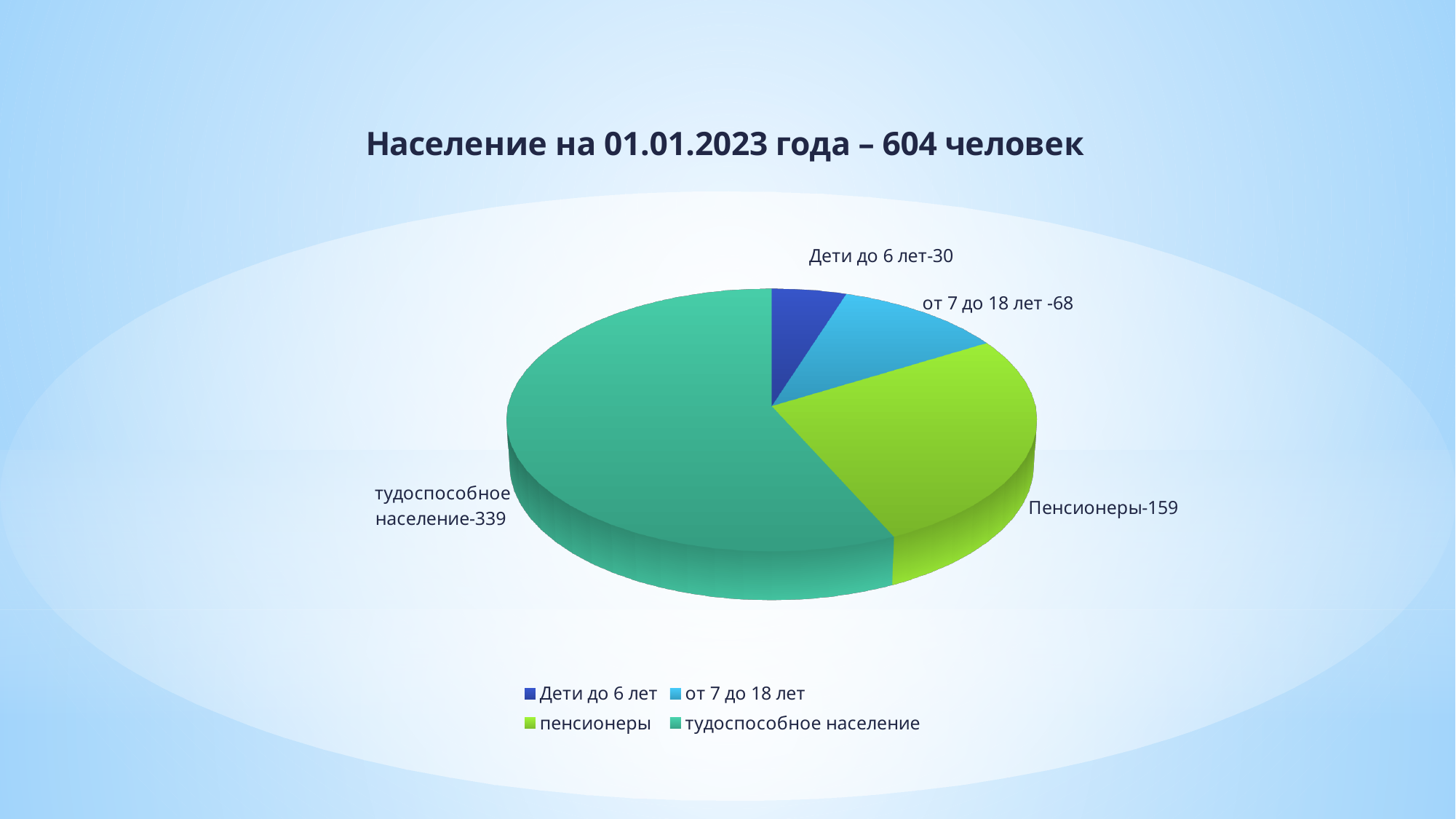
What is the value for Пенсионеры? 159 What is the title of the chart? Население на 01.01.2023 года – 604 человек What is the value for от 7 до 18 лет? 68 What is the value for тудоспособное население? 339 Which category has the largest slice of the pie? тудоспособное население Which category has the smallest slice of the pie? Дети до 6 лет Which is larger, the value for Пенсионеры or the value for от 7 до 18 лет? Пенсионеры What is the difference between the values for от 7 до 18 лет and Дети до 6 лет? 38 What is the value for Дети до 6 лет? 30 What is the difference between the values for тудоспособное население and Пенсионеры? 180 How many categories does the pie chart show? 4 What type of chart is shown on the slide? Pie chart